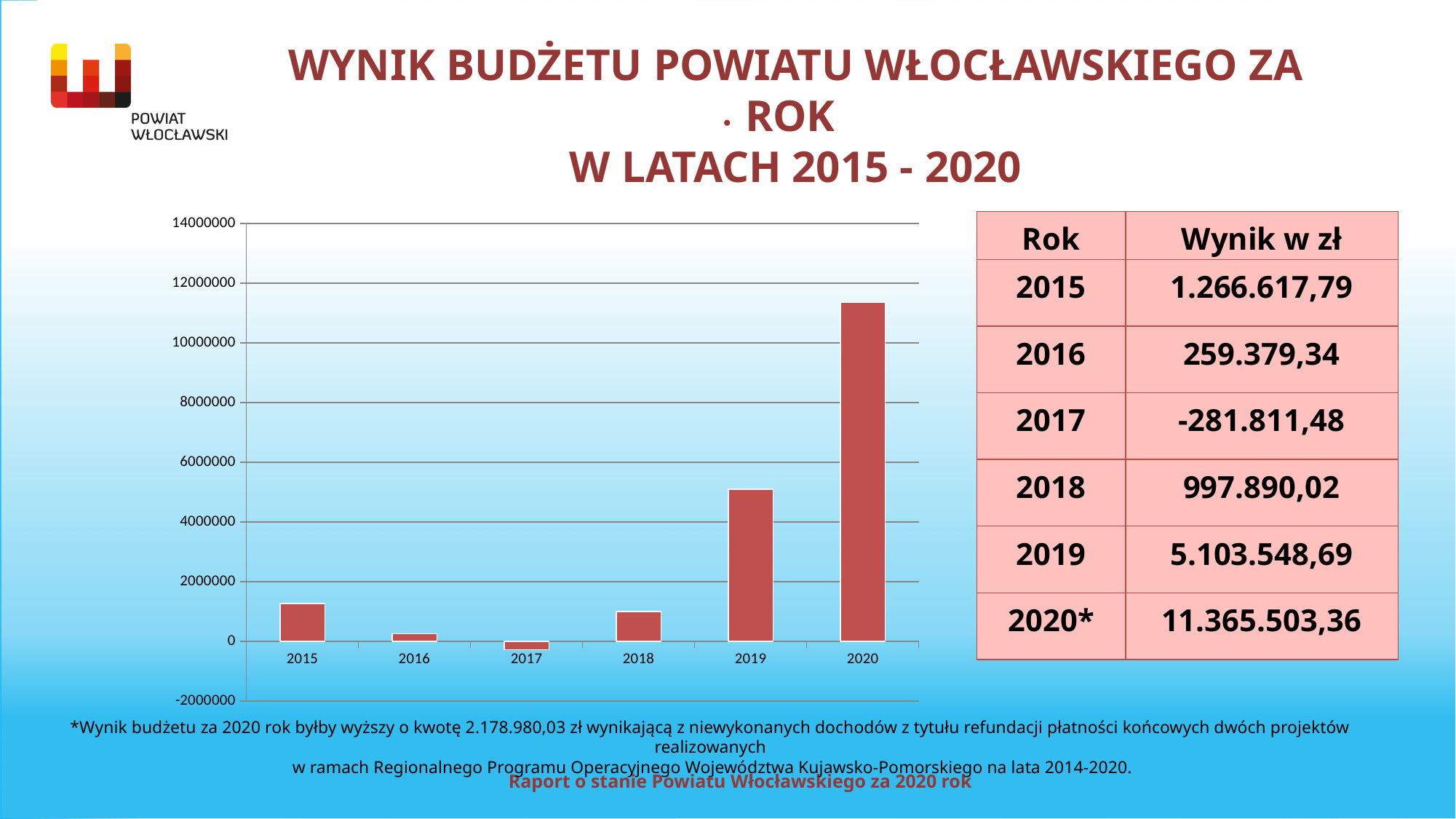
What is the lowest tick value shown on the vertical axis of the chart? -2000000 What is the budget result (Wynik w zł) for 2019? 5.103.548,69 Do the values rise or fall from 2017 to 2020? rise Is the value for 2018 greater or less than 2000000? less What is the budget result (Wynik w zł) for 2017? -281.811,48 Which year has the highest budget result in the chart? 2020 Is the value for 2020 greater or less than 10000000? greater Which is larger, the value for 2015 or the value for 2016? 2015 Which year has the lowest budget result in the chart? 2017 How many years are plotted on the x axis of the chart? 6 What is the budget result (Wynik w zł) for 2020? 11.365.503,36 What kind of chart is shown on the slide? bar chart